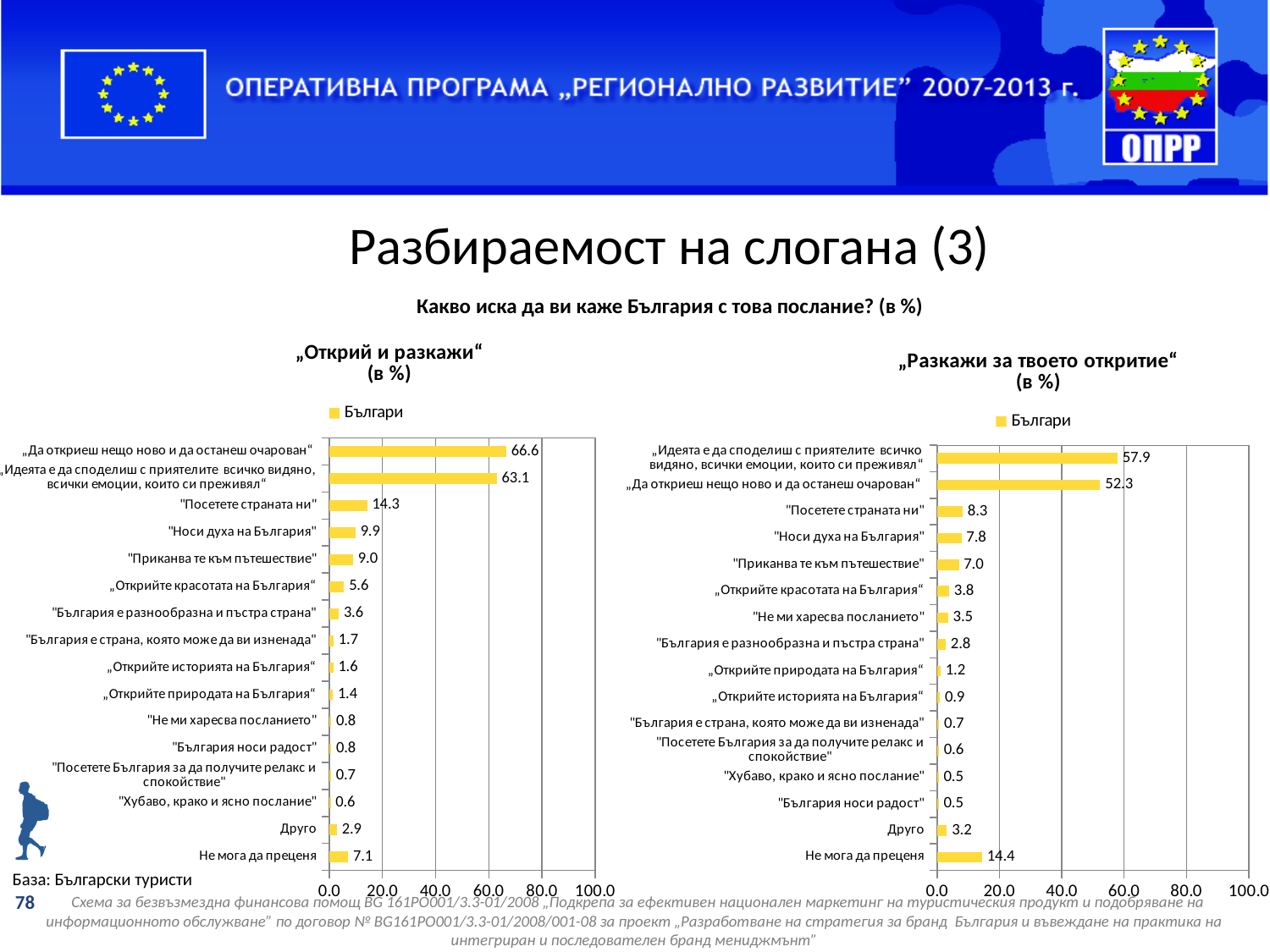
In the chart titled „Разкажи за твоето откритие“, which category has the highest value? „Идеята е да споделиш с приятелите всичко видяно, всички емоции, които си преживял“ How many categories are shown in the chart titled „Разкажи за твоето откритие“? 16 Which is larger: the value for "Не мога да преценя" in the chart „Открий и разкажи“ or in the chart „Разкажи за твоето откритие“? „Разкажи за твоето откритие“ In the chart titled „Открий и разкажи“, is the value for „Да откриеш нещо ново и да останеш очарован“ greater or less than 60.0? greater In the chart titled „Разкажи за твоето откритие“, what is the difference between the values for „Идеята е да споделиш с приятелите всичко видяно, всички емоции, които си преживял“ and „Да откриеш нещо ново и да останеш очарован“? 5.6 In the chart titled „Открий и разкажи“, what is the difference between the values for "Посетете страната ни" and "Носи духа на България"? 4.4 In the chart titled „Разкажи за твоето откритие“, what is the value for "Не мога да преценя"? 14.4 How many series does the legend of the chart titled „Открий и разкажи“ list? 1 What is the legend entry shown in the chart titled „Открий и разкажи“? Българи What type of chart is the chart titled „Разкажи за твоето откритие“? Bar chart In the chart titled „Открий и разкажи“, which category has the highest value? „Да откриеш нещо ново и да останеш очарован“ In the chart titled „Открий и разкажи“, what is the value for "Посетете страната ни"? 14.3